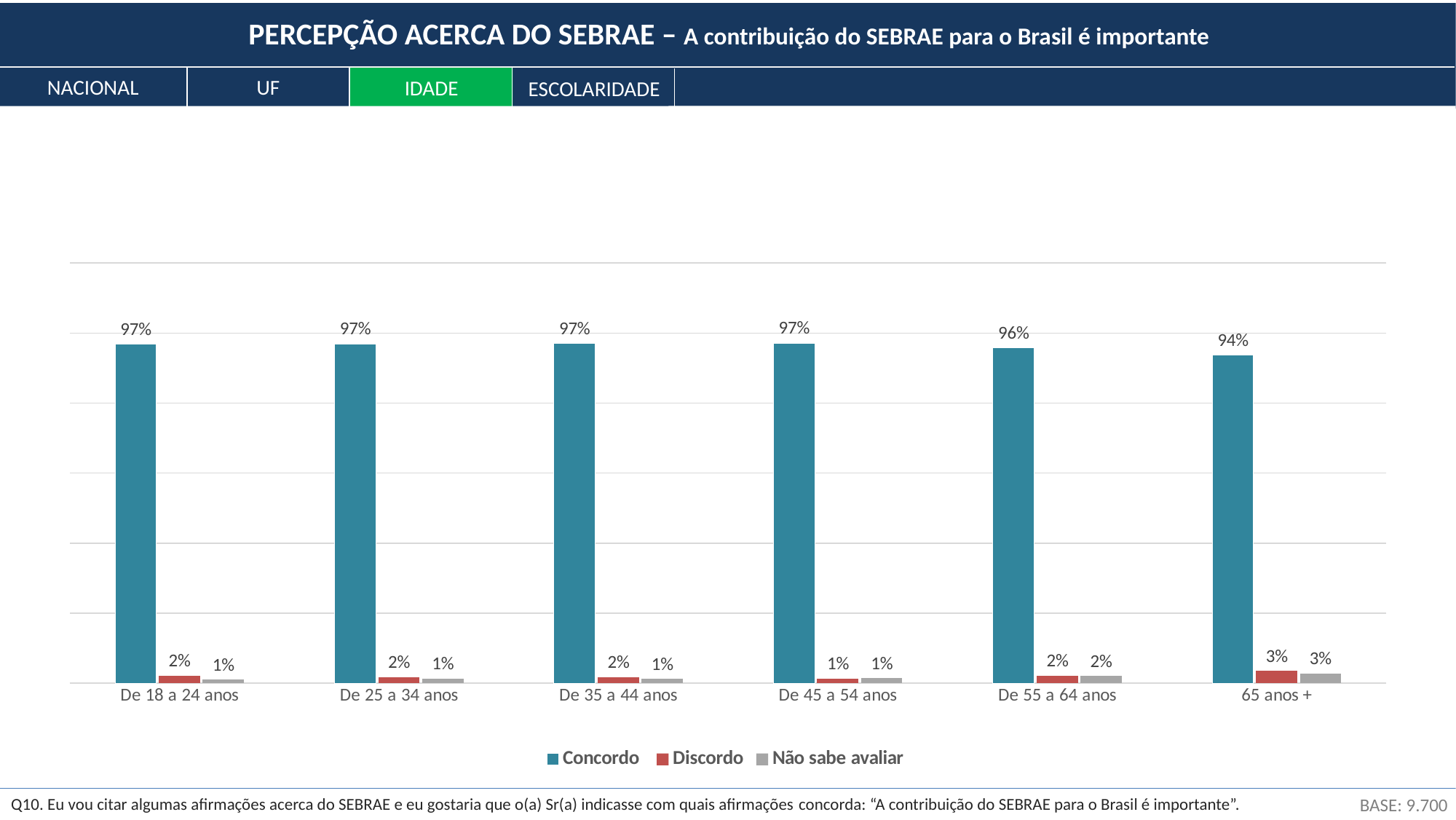
How many series does the legend list? 3 What is the Não sabe avaliar value for De 55 a 64 anos? 2% What kind of chart is shown on the slide? Bar chart Which age group has the highest Discordo value? 65 anos + Which tab is highlighted in green above the chart? IDADE What is the Discordo value for 65 anos +? 3% What is the Concordo value for De 18 a 24 anos? 97% What is the difference between the Concordo values for De 45 a 54 anos and 65 anos +? 3% What is the Concordo value for De 55 a 64 anos? 96% Which is larger, the Discordo value for De 18 a 24 anos or the Discordo value for De 45 a 54 anos? De 18 a 24 anos Which age group has the lowest Concordo value? 65 anos + How many age groups are shown on the x axis? 6